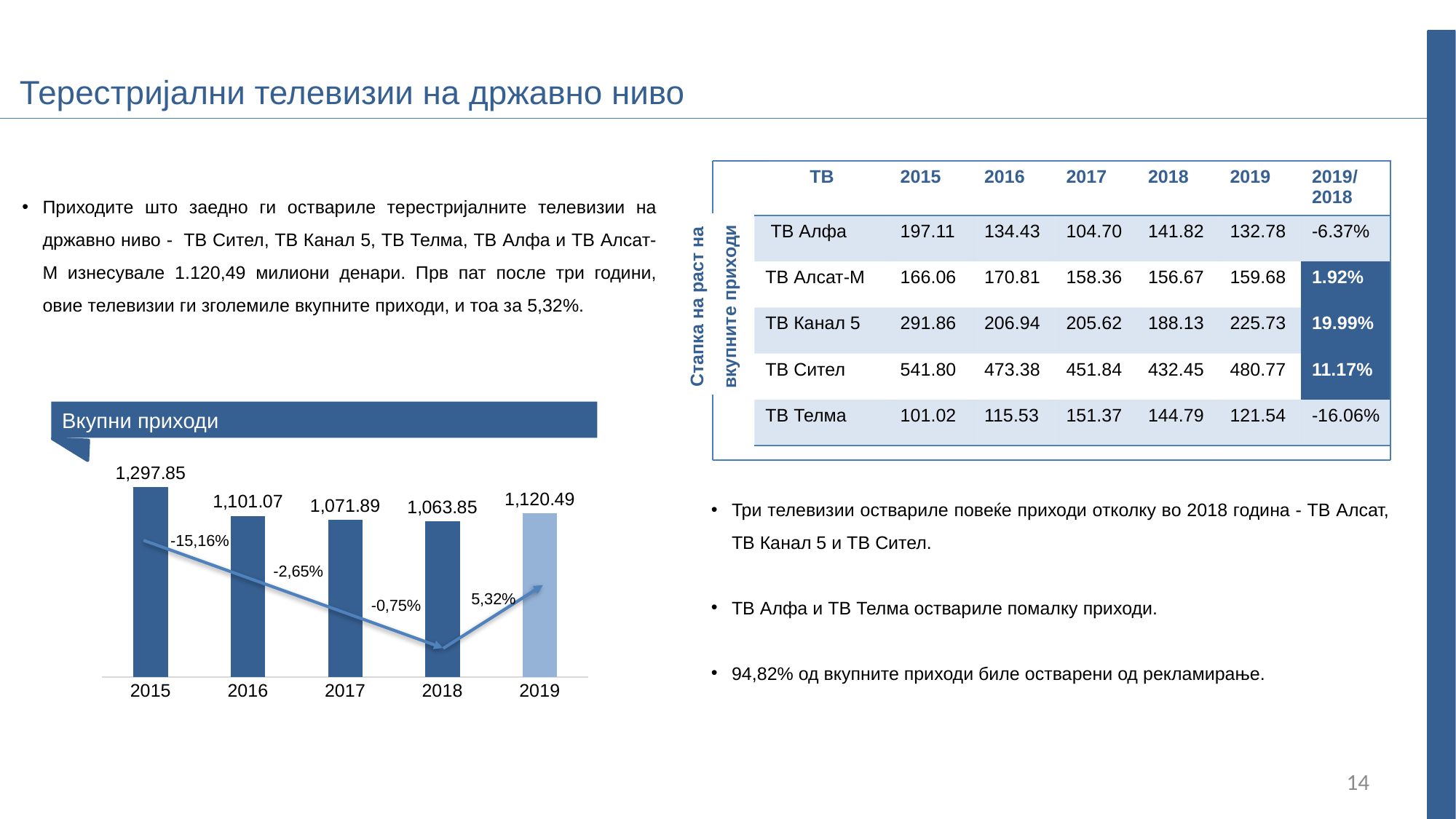
In the "Вкупни приходи" chart, what is the value for 2019? 1,120.49 How many years (bars) are shown in the "Вкупни приходи" chart? 5 In the "Вкупни приходи" chart, which year has the lowest value? 2018 In the "Вкупни приходи" chart, what is the value for 2017? 1,071.89 In the "Вкупни приходи" chart, do the values rise or fall from 2015 to 2018? fall What type of chart is shown under the heading "Вкупни приходи"? bar chart In the "Вкупни приходи" chart, which is larger, the value for 2016 or the value for 2019? 2019 In the "Вкупни приходи" chart, what is the difference between the values for 2015 and 2016? 196.78 In the "Вкупни приходи" chart, what percentage change is annotated between 2018 and 2019? 5,32% In the "Вкупни приходи" chart, what is the difference between the values for 2019 and 2018? 56.64 In the "Вкупни приходи" chart, what is the value for 2015? 1,297.85 In the "Вкупни приходи" chart, which year has the highest value? 2015